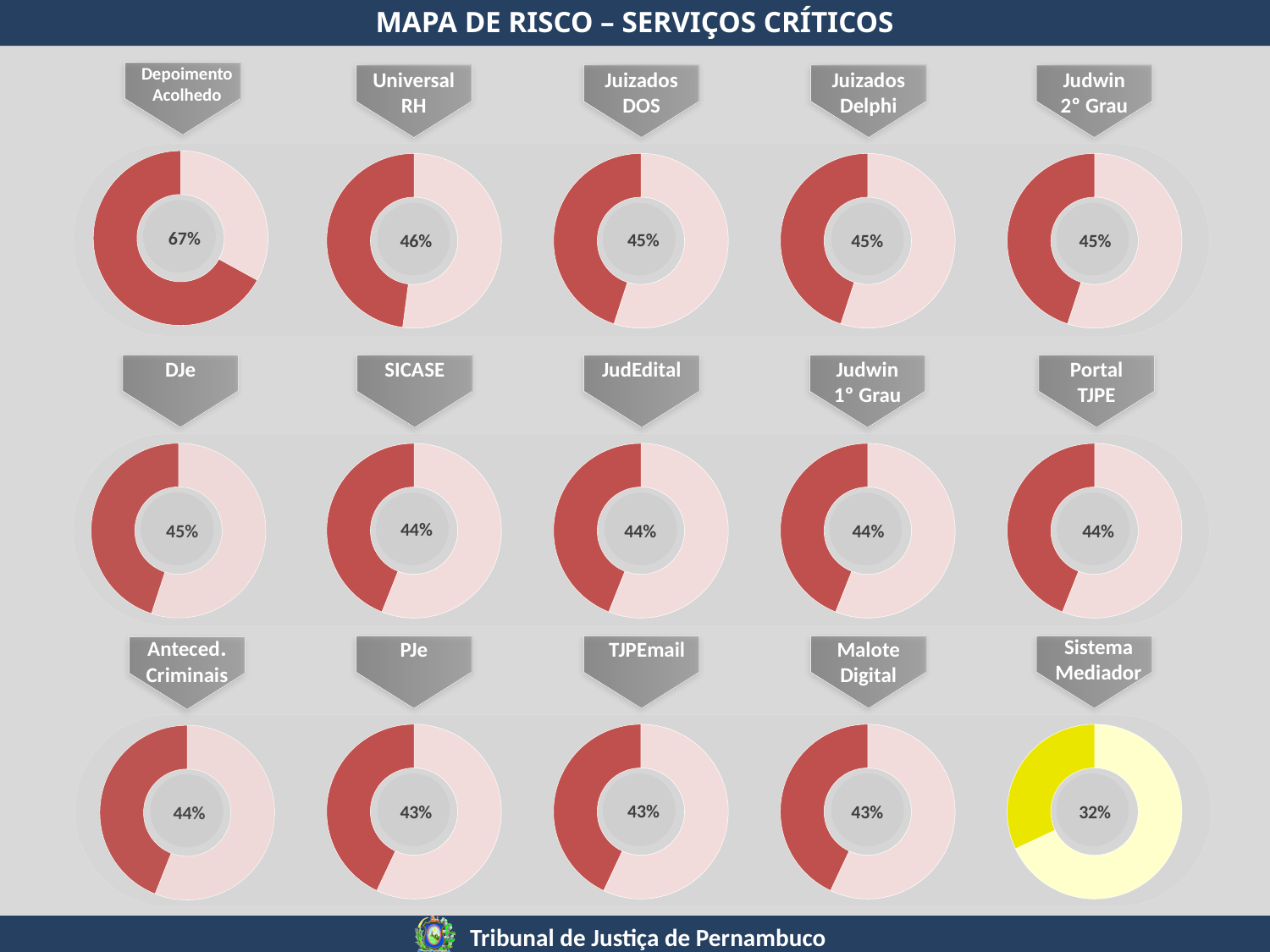
What value is shown in the Universal RH donut chart? 46% What kind of chart is used for each service on the slide? Donut (pie) chart What value is shown in the Portal TJPE donut chart? 44% How many donut charts are shown on the slide? 15 Which service's donut chart is coloured yellow instead of red? Sistema Mediador What value is shown in the PJe donut chart? 43% What value is shown in the Depoimento Acolhedo donut chart? 67% Which service has the lowest percentage among all the donut charts on the slide? Sistema Mediador What value is shown in the Sistema Mediador donut chart? 32% Which service has the highest percentage among all the donut charts on the slide? Depoimento Acolhedo What is the difference between the Depoimento Acolhedo value and the Sistema Mediador value? 35 percentage points Which is larger, the value for Universal RH or the value for Malote Digital? Universal RH